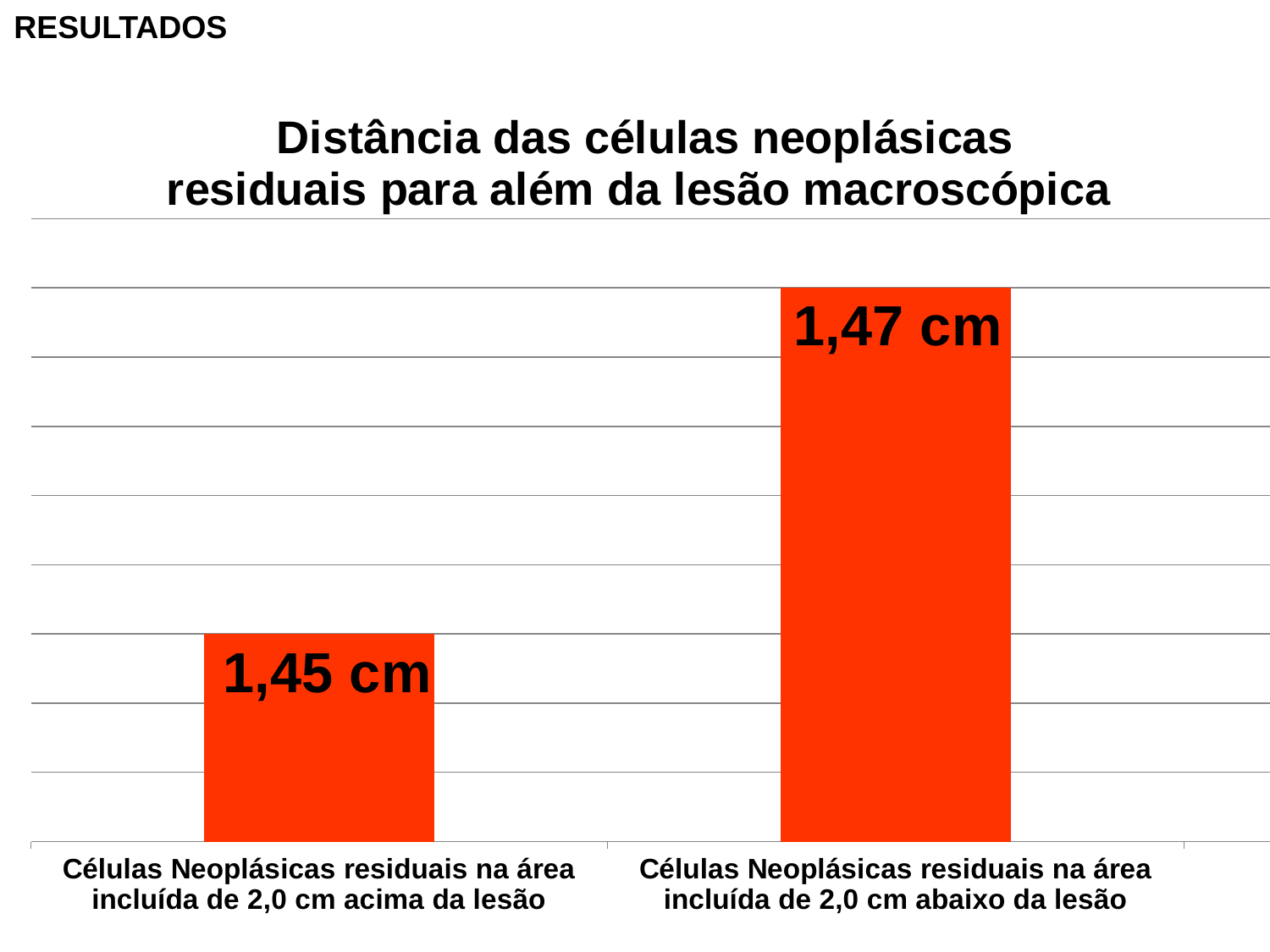
What is the difference between the value for the area 2,0 cm below the lesion and the value for the area 2,0 cm above the lesion? 0,02 cm What colour are the bars in the chart? red-orange What value is shown for 'Células Neoplásicas residuais na área incluída de 2,0 cm abaixo da lesão'? 1,47 cm What value is shown for 'Células Neoplásicas residuais na área incluída de 2,0 cm acima da lesão'? 1,45 cm Which category has the lower value? Células Neoplásicas residuais na área incluída de 2,0 cm acima da lesão What is the title of the chart? Distância das células neoplásicas residuais para além da lesão macroscópica Is the value for the area 2,0 cm above the lesion larger or smaller than the value for the area 2,0 cm below the lesion? smaller How many bars are plotted in the chart? 2 Which category has the higher value? Células Neoplásicas residuais na área incluída de 2,0 cm abaixo da lesão What kind of chart is shown on the slide? bar chart